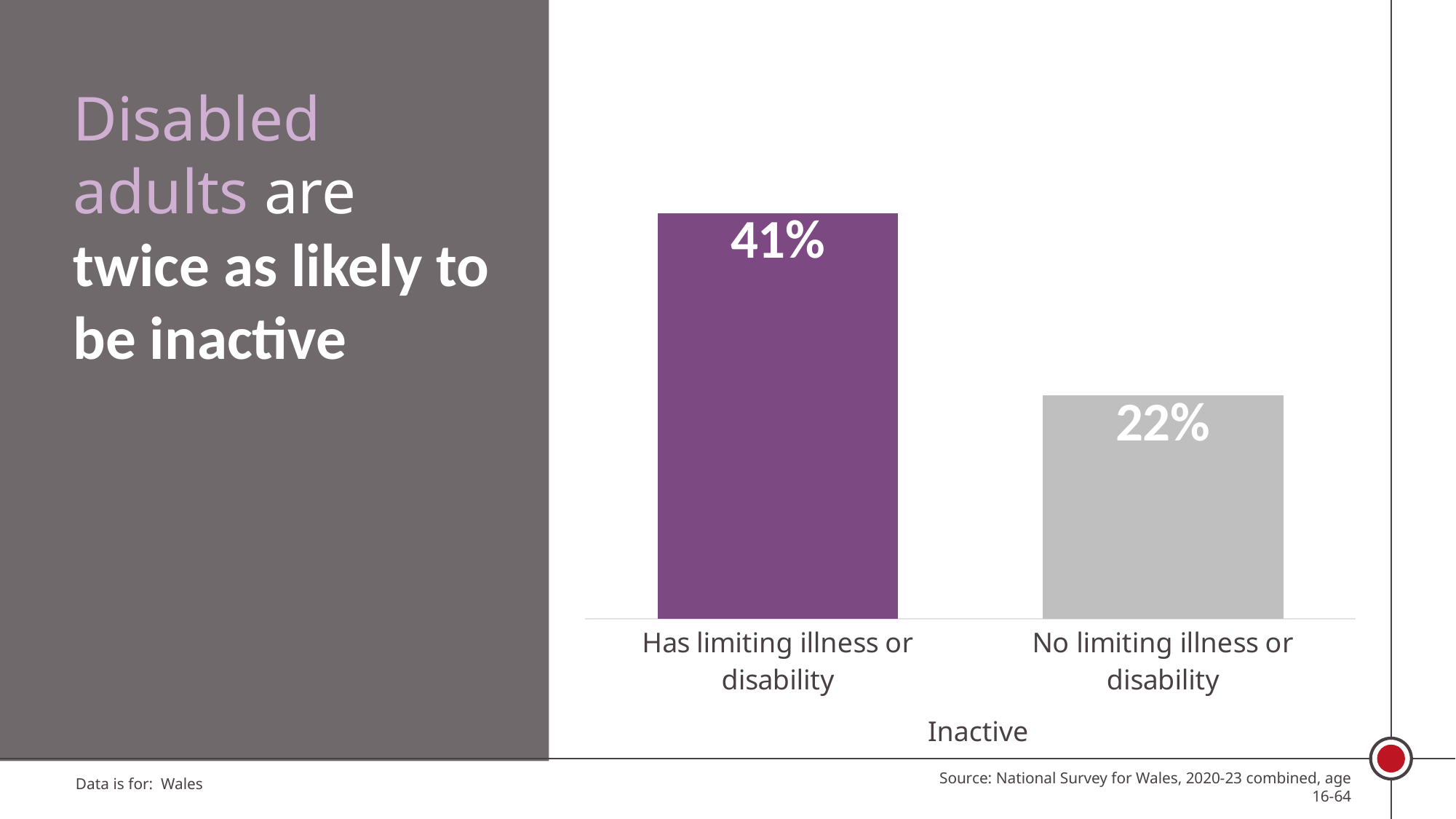
Which category has the lower inactive percentage? No limiting illness or disability What is the difference in percentage points between the 'Has limiting illness or disability' bar and the 'No limiting illness or disability' bar? 19 percentage points What is the inactive percentage for adults with no limiting illness or disability? 22% Do the values fall or rise moving from the left bar to the right bar? fall Is the value for 'Has limiting illness or disability' larger or smaller than the value for 'No limiting illness or disability'? larger What is the inactive percentage for adults who have a limiting illness or disability? 41% Which category has the higher inactive percentage? Has limiting illness or disability What colour is the bar for 'Has limiting illness or disability'? Purple What kind of chart is shown on the slide? Bar chart How many categories are shown on the chart? 2 What is the label shown beneath the category axis of the chart? Inactive